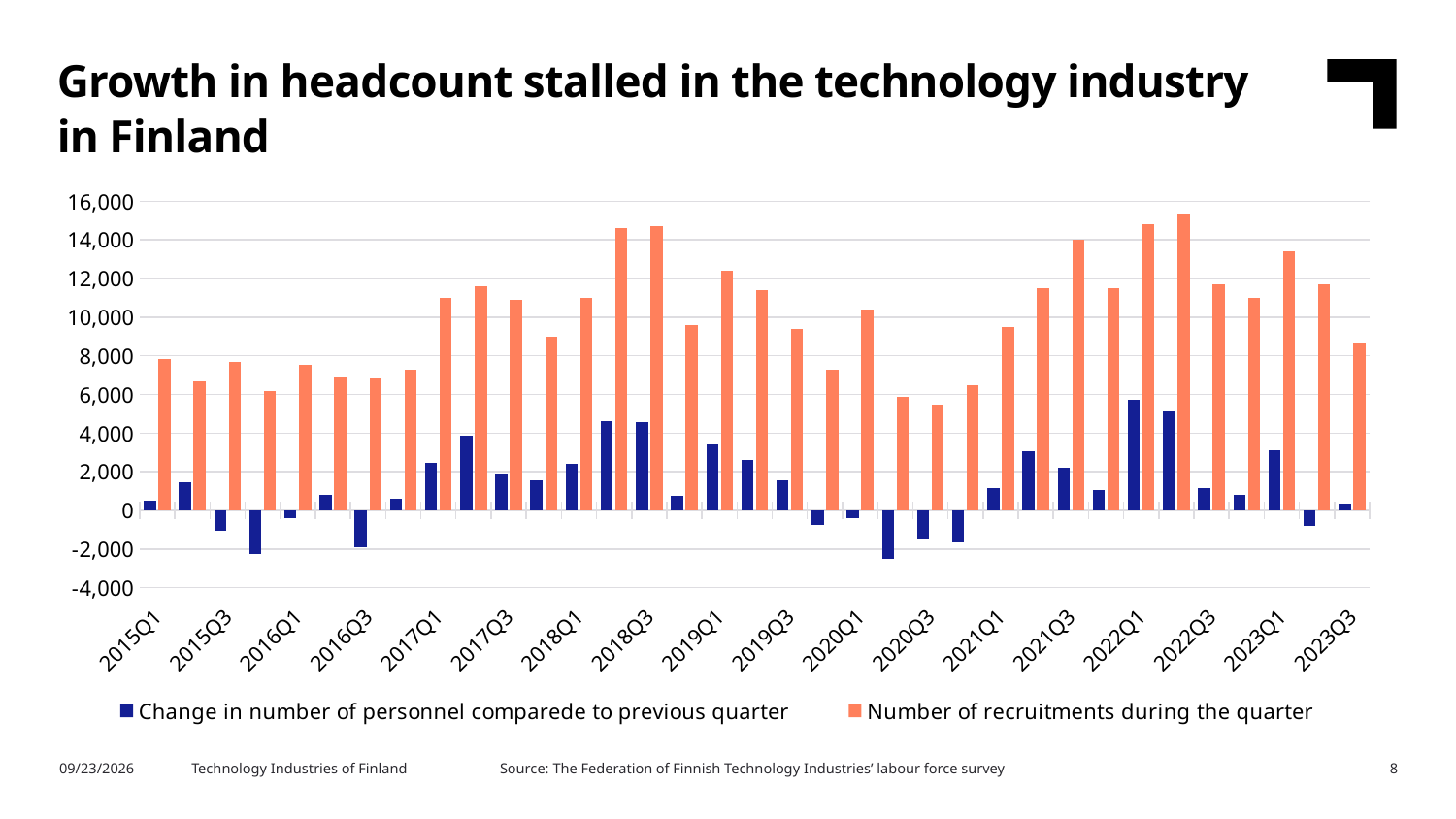
Is the number of recruitments in 2022Q2 greater or less than 14,000? greater Is the change in number of personnel in 2020Q2 greater or less than -2,000? less Is the change in number of personnel in 2018Q2 greater or less than 4,000? greater In which quarter is the change in number of personnel compared to previous quarter highest? 2022Q1 How many quarters are plotted on the x axis, from 2015Q1 to 2023Q3? 35 In which quarter is the number of recruitments during the quarter highest? 2022Q2 What kind of chart is shown on the slide? Bar chart Which colour represents the number of recruitments during the quarter in the legend? Orange Which quarter had more recruitments, 2022Q2 or 2015Q1? 2022Q2 How many series does the legend list? 2